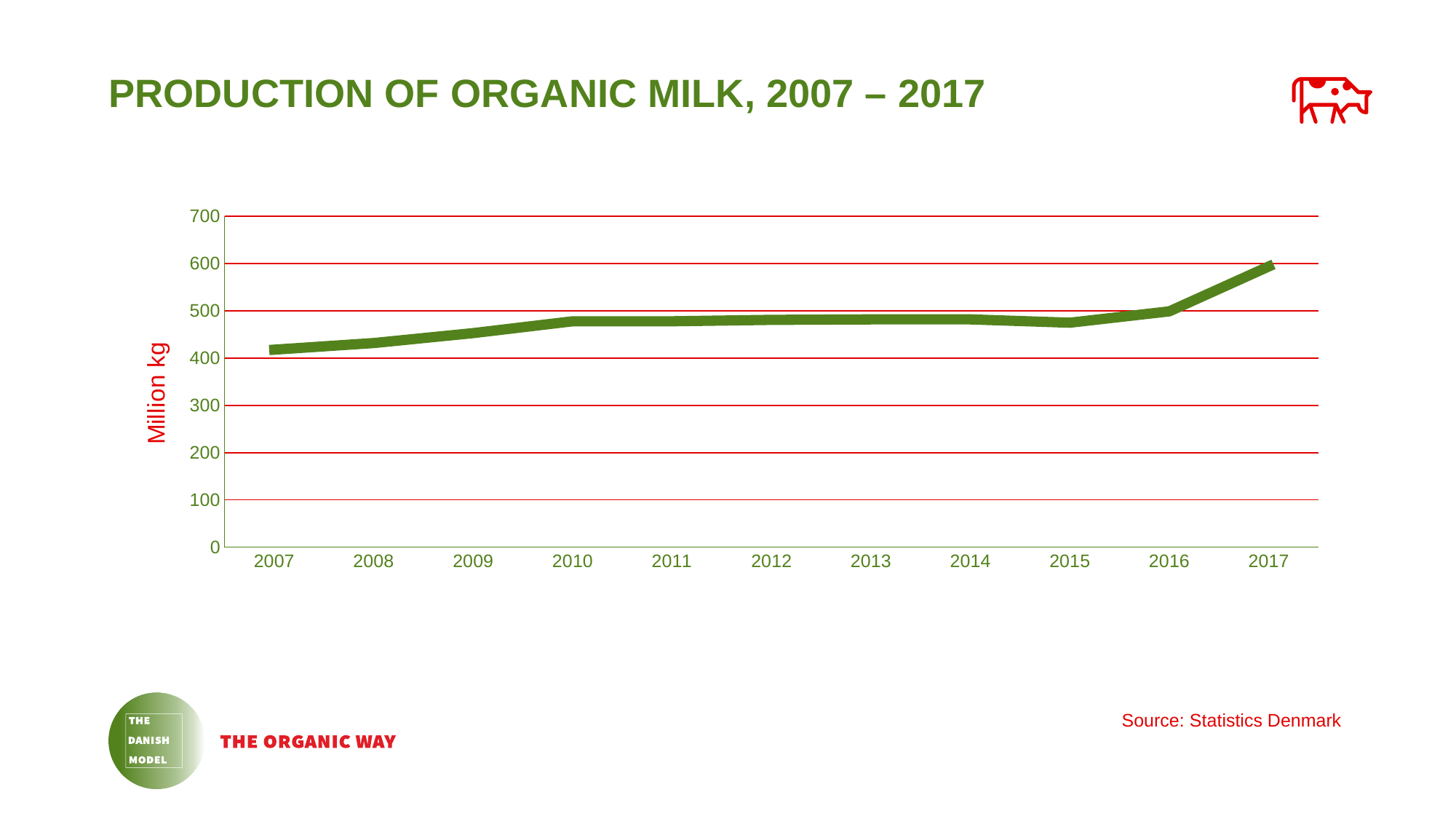
Is the value for 2007 greater or less than 400? greater Which year has the larger value, 2007 or 2017? 2017 Overall, does the production of organic milk rise or fall from 2007 to 2017? rise Is the value for 2015 greater or less than 500? less What is the source of the data cited on the slide? Statistics Denmark How many years are plotted on the x axis of the chart? 11 What is the label on the y axis of the chart? Million kg Which year has the lowest production of organic milk? 2007 Is the value for 2010 greater or less than 500? less Which year has the highest production of organic milk? 2017 What kind of chart is shown on the slide? line chart